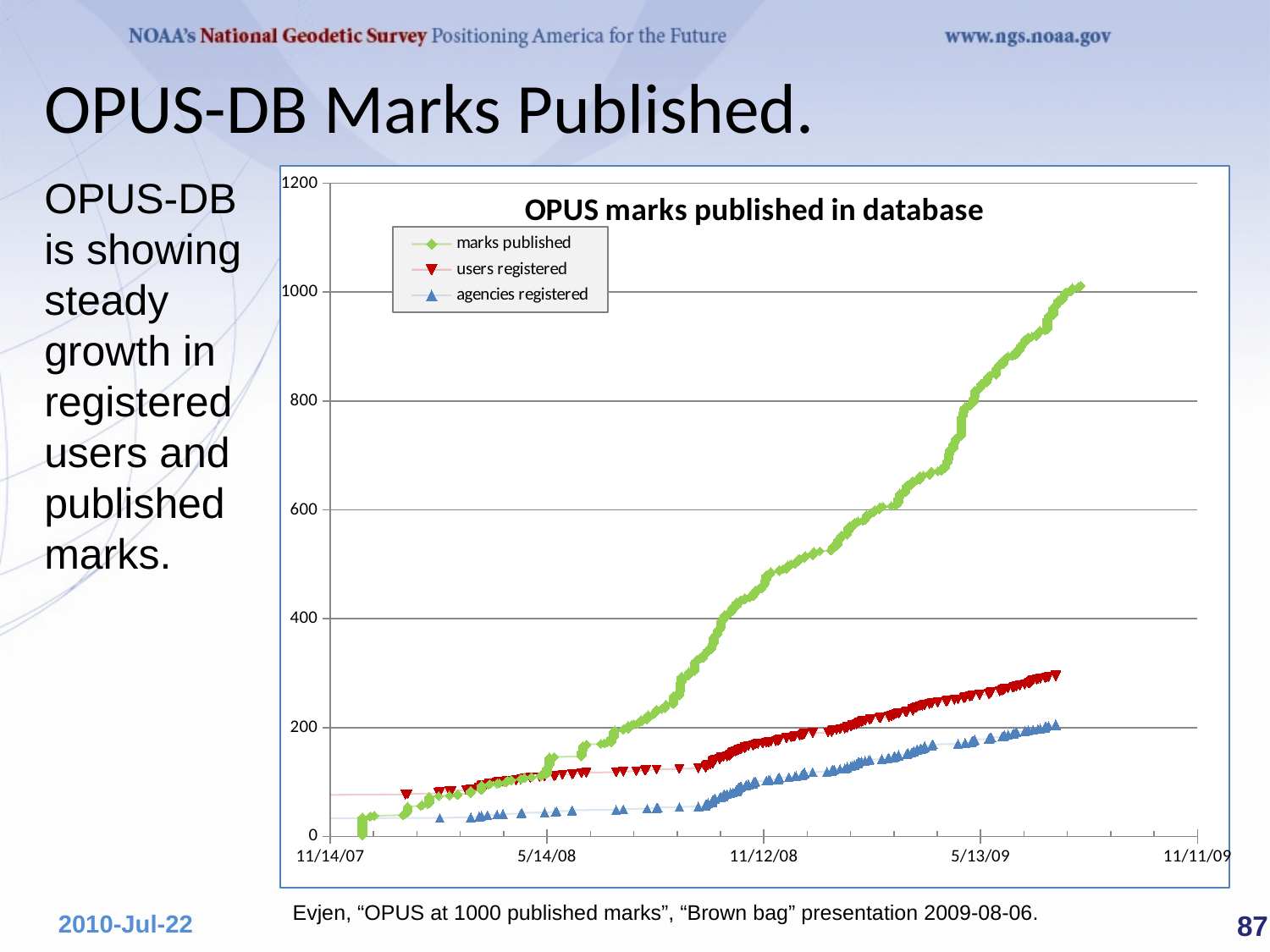
Which series has the lowest values at the right end of the chart? agencies registered Do the values for marks published rise or fall over time along the x axis? rise What kind of chart is shown on the slide? line chart What is the title of the chart? OPUS marks published in database Is the final value for agencies registered greater or less than 100? greater How many series does the chart legend list? 3 Is the final value for marks published greater or less than 800? greater Is the value for marks published at 11/12/08 greater or less than 600? less At 5/13/09, which is larger: users registered or agencies registered? users registered Which series has the highest values at the right end of the chart? marks published Which series is plotted with green markers? marks published